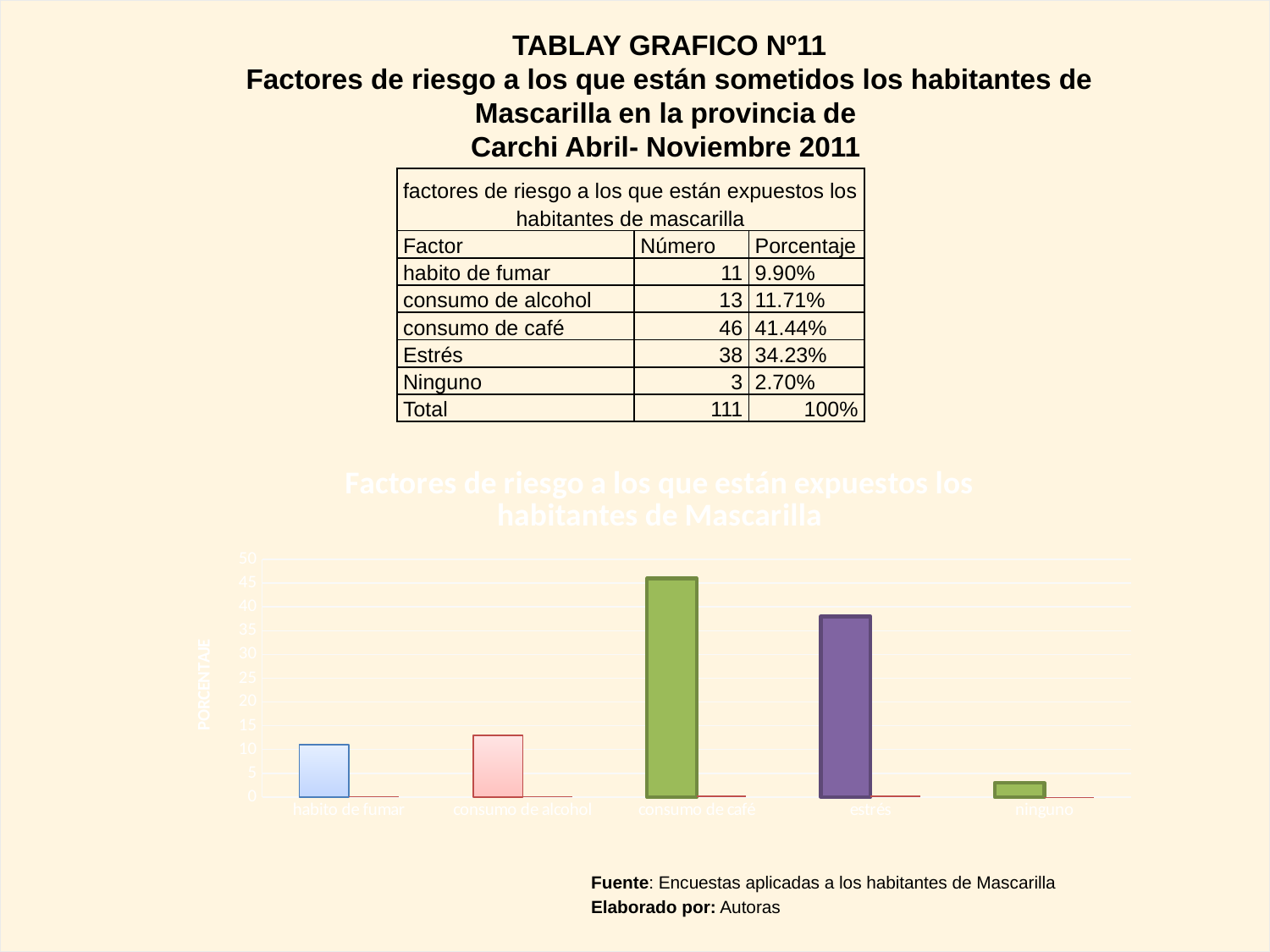
Is the bar for consumo de café greater or less than 40? greater Is the bar for ninguno greater or less than 5? less Which category has the shortest bar in the chart? ninguno According to the table, what is the Porcentaje for Estrés? 34.23% Which bar is taller, estrés or consumo de alcohol? estrés According to the table, what is the Número for consumo de café? 46 Is the bar for habito de fumar greater or less than 15? less Which category has the tallest bar in the chart? consumo de café How many categories are plotted on the bar chart? 5 What kind of chart is shown on the slide? bar chart According to the table, what is the difference in Número between consumo de café and Estrés? 8